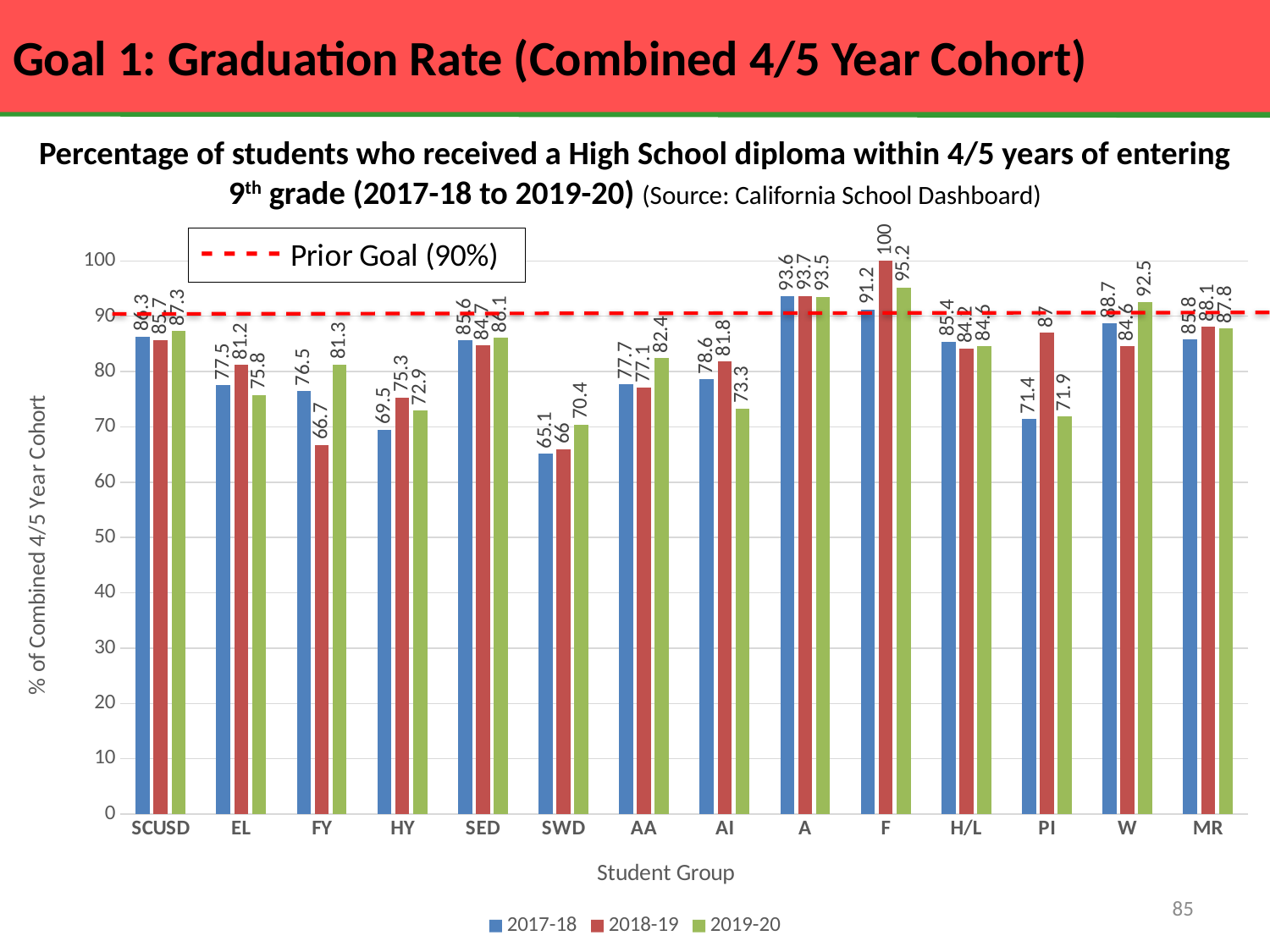
For PI, which year has the larger value, 2018-19 or 2019-20? 2018-19 How many series does the legend list? 3 Do the values for SWD rise or fall from 2017-18 to 2019-20? rise What is the value for F in 2018-19? 100 What is the difference between the 2019-20 and 2018-19 values for FY? 14.6 Which student group has the highest value in 2019-20? F What kind of chart is shown on the slide? bar chart Is the value for SWD in 2017-18 greater or less than 70? less What is the value for FY in 2018-19? 66.7 What value does the dashed Prior Goal line represent? 90% Which student group has the lowest value in 2017-18? SWD How many student groups are shown on the x axis? 14